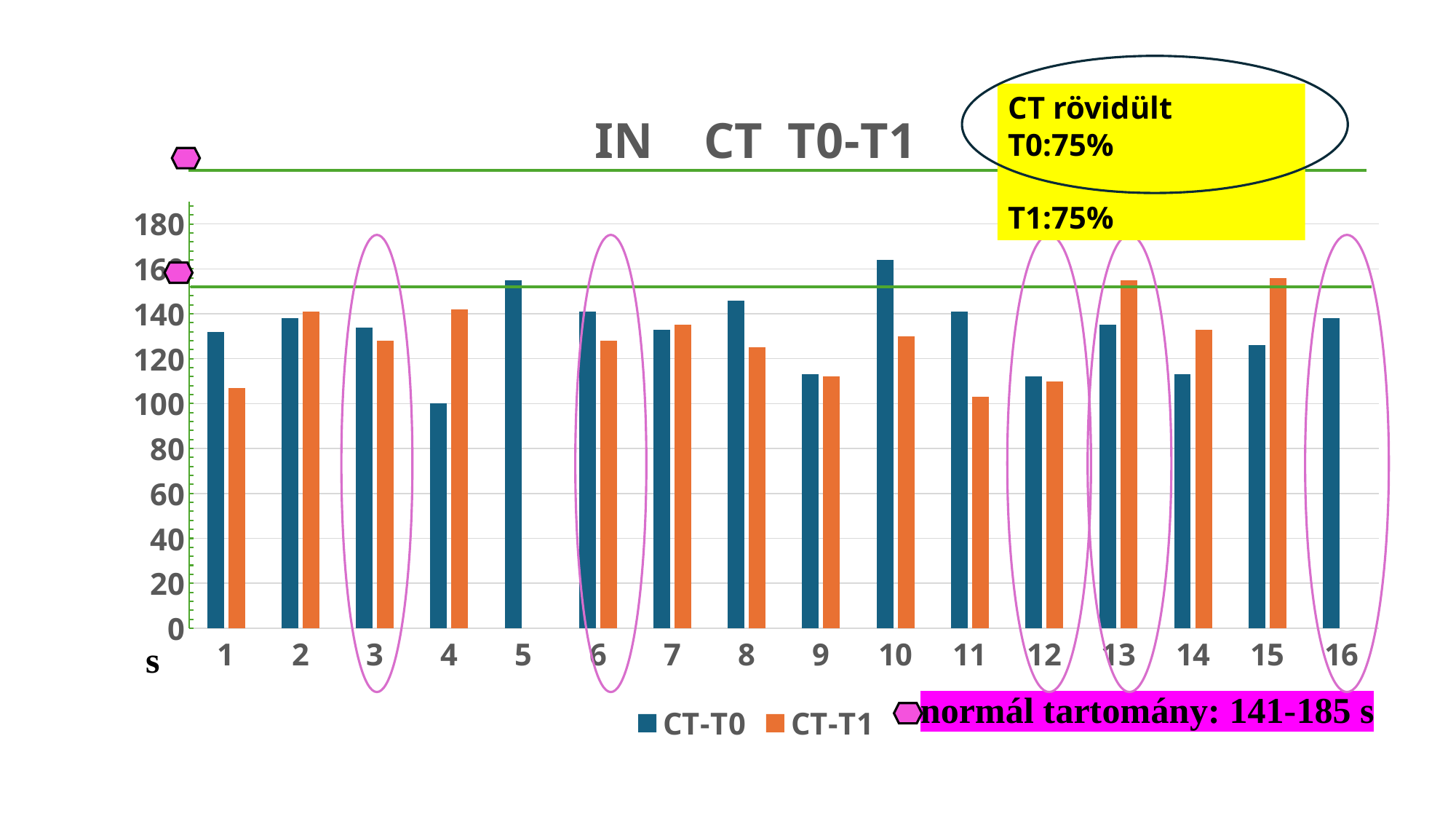
What are the two series named in the legend? CT-T0 and CT-T1 Is the CT-T1 value for category 13 greater or less than 140? greater Which category has the highest CT-T0 value? 10 Which category has the lowest CT-T0 value? 4 How many series does the legend list? 2 What kind of chart is shown on the slide? bar chart What is the title of the chart? IN CT T0-T1 How many categories are shown on the x axis? 16 Is the CT-T0 value for category 9 greater or less than 120? less Is the CT-T0 value for category 5 greater or less than 140? greater For category 1, which is larger, CT-T0 or CT-T1? CT-T0 For category 13, which is larger, CT-T0 or CT-T1? CT-T1